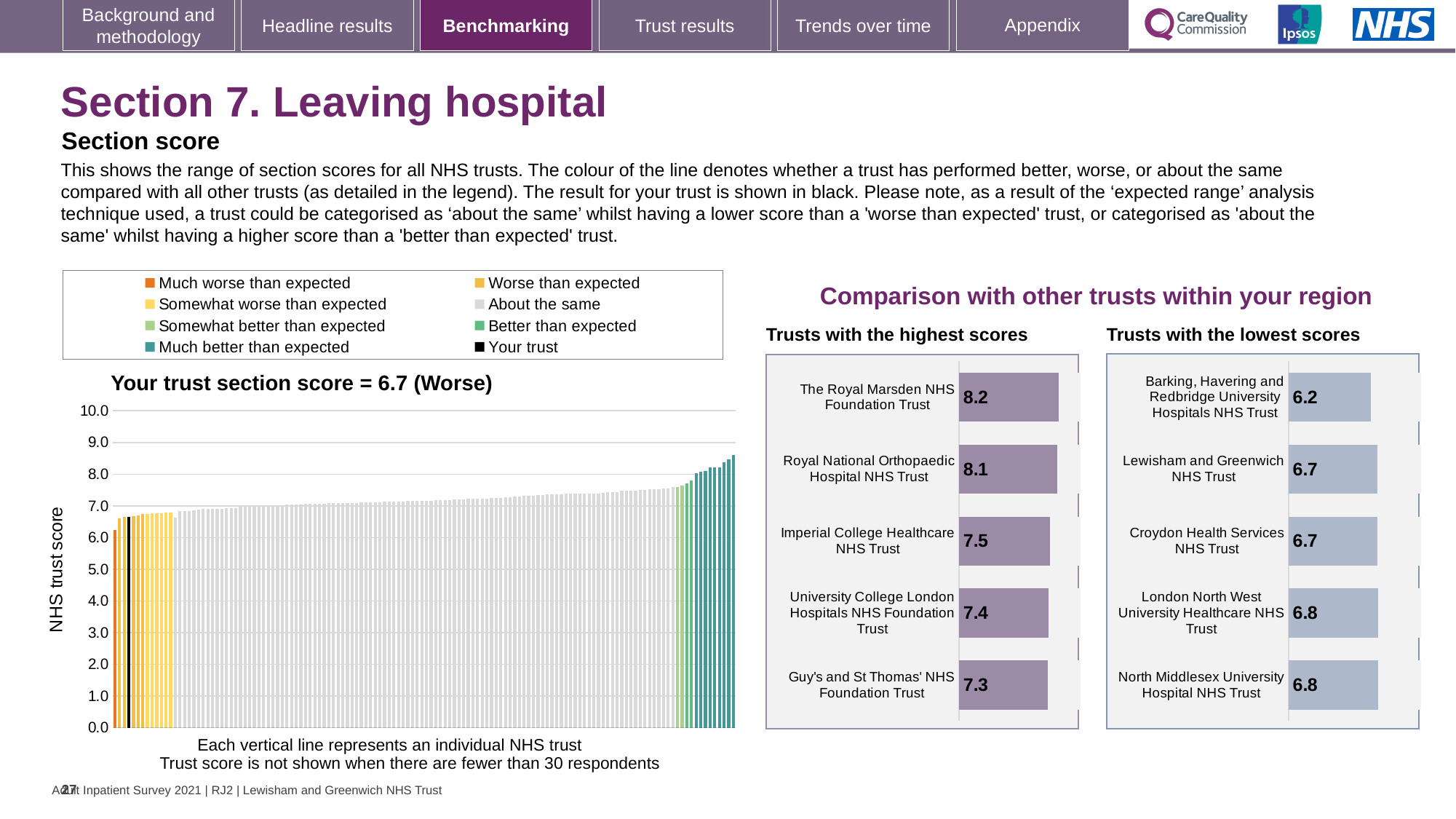
In the 'Your trust section score' chart, do the bar values rise or fall from left to right? rise In the 'Trusts with the highest scores' chart, what is the score for Imperial College Healthcare NHS Trust? 7.5 In the 'Trusts with the lowest scores' chart, which trust has the lowest score? Barking, Havering and Redbridge University Hospitals NHS Trust In the 'Your trust section score' chart, is the value of the tallest bar greater or less than 8.0? greater In the 'Trusts with the lowest scores' chart, which has the larger score: Lewisham and Greenwich NHS Trust or London North West University Healthcare NHS Trust? London North West University Healthcare NHS Trust In the 'Your trust section score' chart, how many entries does the legend list? 8 In the 'Your trust section score' chart, what is the section score for your trust, as stated in the chart title? 6.7 In the 'Trusts with the lowest scores' chart, how many trusts are shown? 5 In the 'Trusts with the highest scores' chart, which trust has the highest score? The Royal Marsden NHS Foundation Trust In the 'Your trust section score' chart, what kind of chart is shown? bar chart In the 'Trusts with the highest scores' chart, what is the difference between the scores of The Royal Marsden NHS Foundation Trust and Guy's and St Thomas' NHS Foundation Trust? 0.9 In the 'Your trust section score' chart, what is the label on the vertical axis? NHS trust score